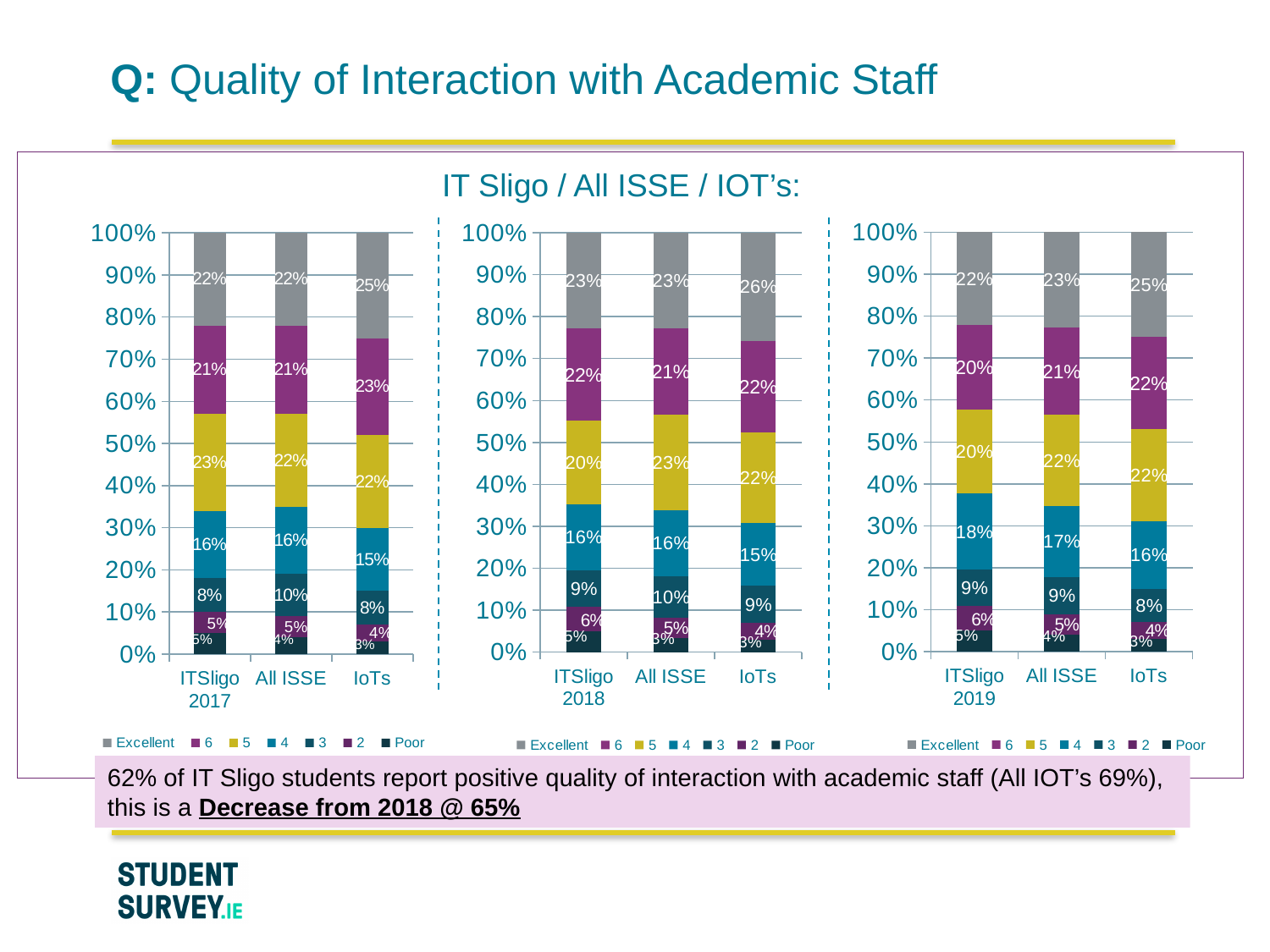
How many series does the legend of each chart list? 7 What is the title shown above the three charts? IT Sligo / All ISSE / IOT's: In the right-hand chart (2019), which category has the lowest Poor percentage? IoTs How many categories are shown on the x axis of the middle chart (2018)? 3 In the right-hand chart (2019), is the '4' rating segment larger for ITSligo or for IoTs? ITSligo In the middle chart (2018), which category has the highest Excellent percentage? IoTs In the right-hand chart (2019), what is the ITSligo value for the '4' rating segment? 18% In the right-hand chart (2019), what percentage of ITSligo students rated the quality of interaction as Excellent? 22% What type of chart is used in each of the three panels on the slide? Stacked bar chart In the middle chart (2018), what is the IoTs value for the Excellent segment? 26% In the left-hand chart (2017), what is the All ISSE value for the '3' rating segment? 10% In the left-hand chart (2017), what is the difference between the IoTs Excellent value and the ITSligo Excellent value? 3%